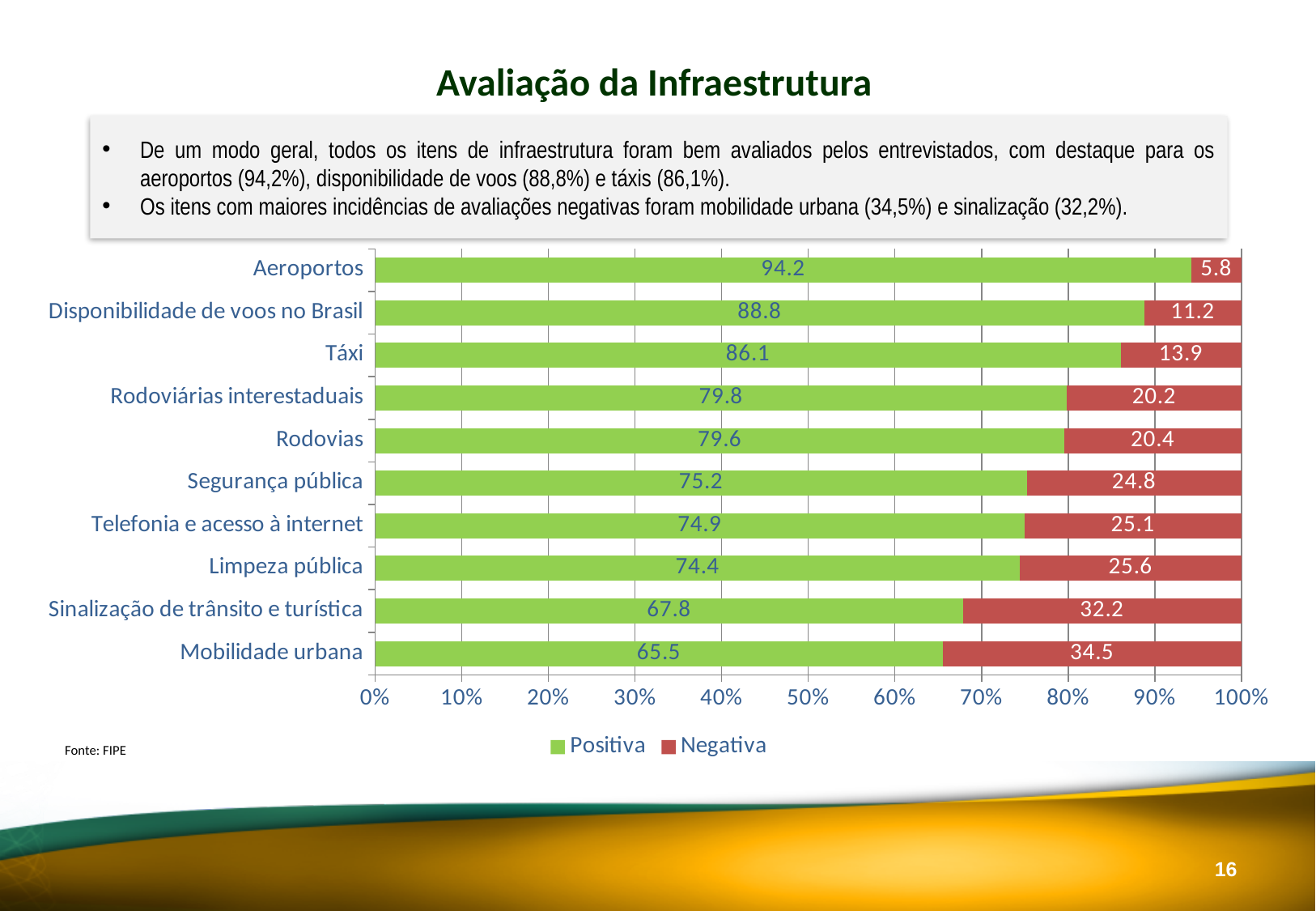
What kind of chart is shown on the slide? Stacked bar chart What is the Negativa value for Mobilidade urbana? 34.5 Which category has the lowest Positiva value? Mobilidade urbana What is the Positiva value for Aeroportos? 94.2 What is the Positiva value for Segurança pública? 75.2 How many series does the legend list? 2 What colour represents the Negativa series? Red What is the difference between the Negativa values for Sinalização de trânsito e turística and Táxi? 18.3 How many categories are shown in the chart? 10 Which is larger, the Positiva value for Rodovias or for Limpeza pública? Rodovias What is the total of the stacked bar for Disponibilidade de voos no Brasil? 100 Which category has the highest Positiva value? Aeroportos